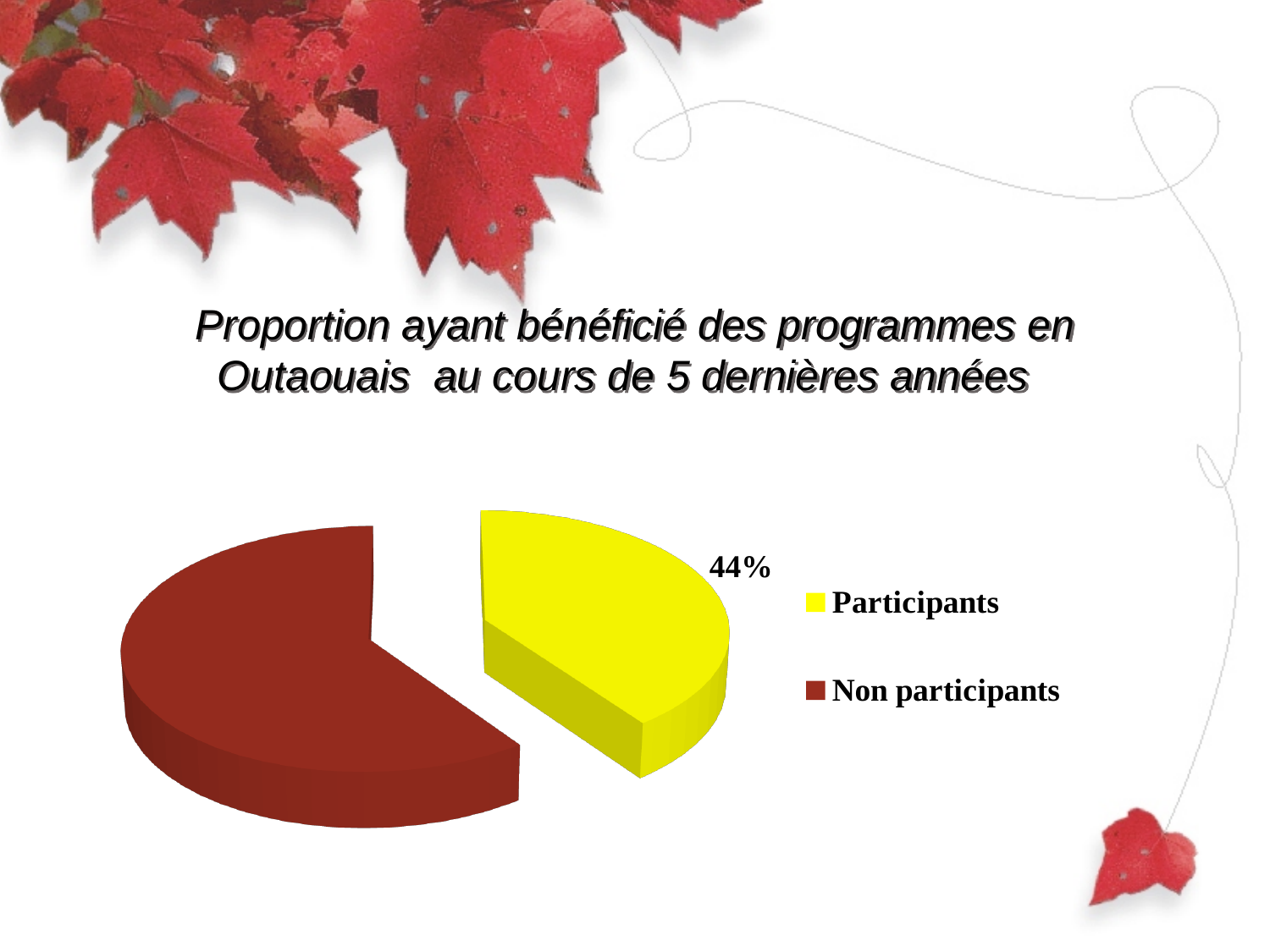
Which is larger, the Participants slice or the Non participants slice? Non participants What percentage is shown for the Participants slice? 44% What colour is the Participants slice in the pie chart? yellow How many entries does the legend of the pie chart list? 2 What kind of chart is shown on the slide? pie chart How many slices does the pie chart have? 2 What is the title of the chart on the slide? Proportion ayant bénéficié des programmes en Outaouais au cours de 5 dernières années Which slice of the pie chart is the smallest? Participants Which slice of the pie chart is the largest? Non participants What share of the pie does the Participants slice represent? 44%